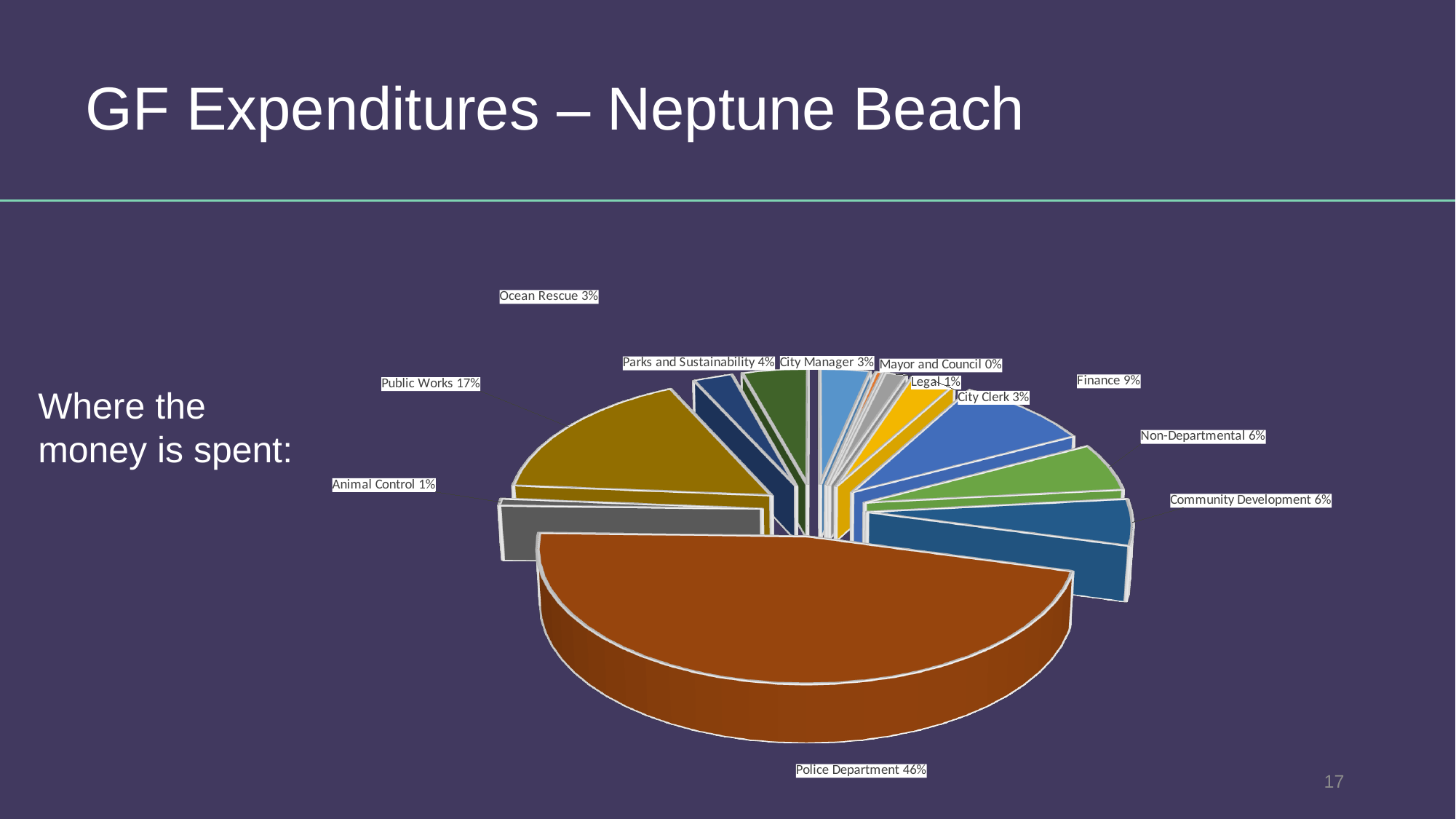
What is the title of the slide containing the chart? GF Expenditures – Neptune Beach What share of GF expenditures goes to the Police Department? 46% Which category has the smallest share of the pie? Mayor and Council Which category has the largest share of the pie? Police Department What percentage is shown for Non-Departmental? 6% What share of GF expenditures goes to Public Works? 17% What kind of chart is shown on the slide? Pie chart What is the difference in percentage points between the Police Department and Public Works shares? 29 What percentage is shown for Finance? 9% What percentage is shown for Parks and Sustainability? 4% How many categories are shown in the pie chart? 12 Which is larger, the share for Finance or the share for Community Development? Finance